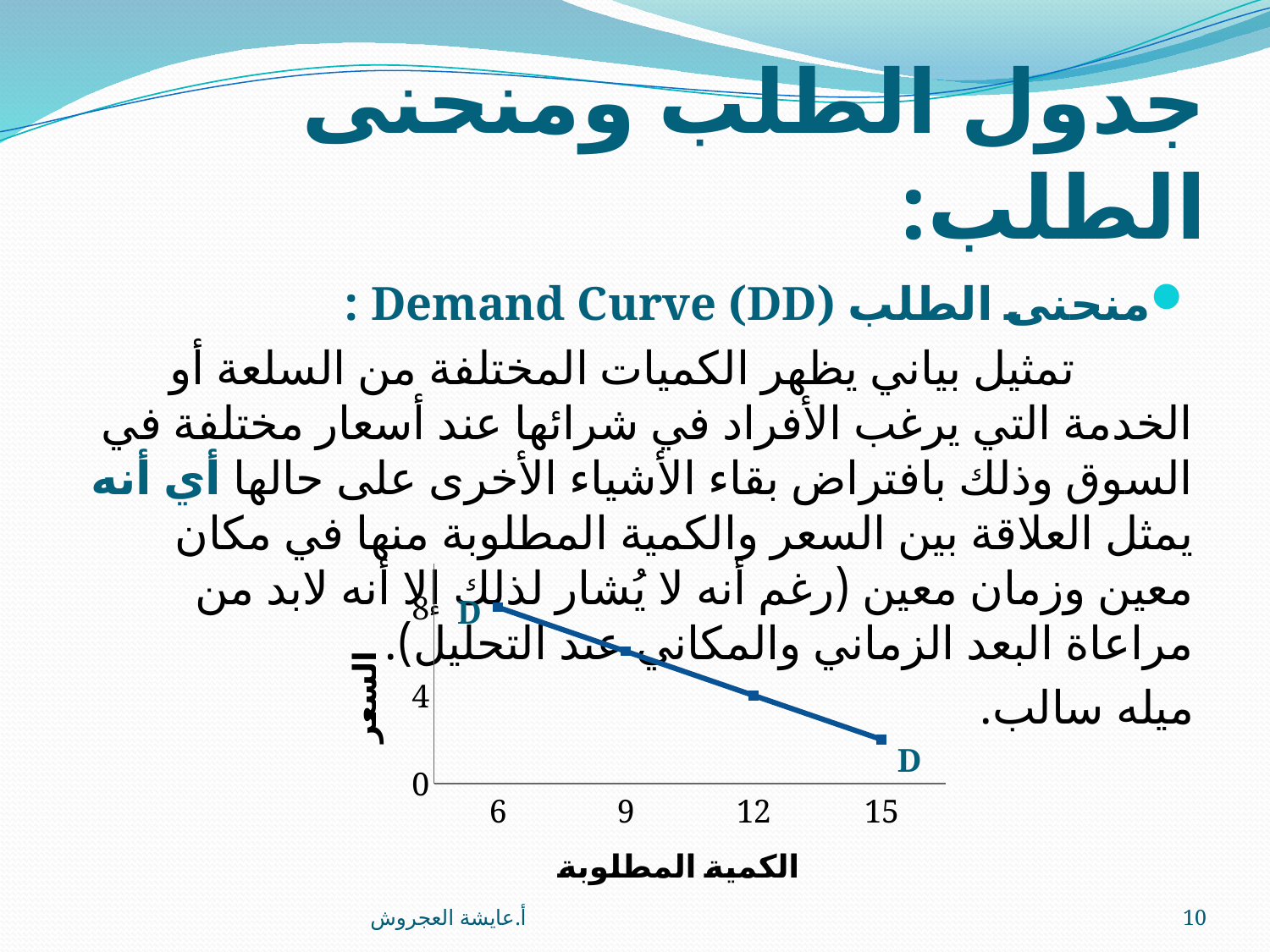
Is the price for a quantity demanded of 15 greater or less than 4? less Which has the higher price: a quantity demanded of 6 or a quantity demanded of 15? 6 What kind of chart is shown on the slide? line chart What letter labels the two ends of the demand curve? D How many data points are plotted on the demand curve? 4 What is the title of the x axis of the chart? الكمية المطلوبة Do the values rise or fall as the quantity demanded increases along the x axis? fall What is the price (السعر) when the quantity demanded is 6? 8 At which quantity demanded is the price lowest? 15 What is the price (السعر) when the quantity demanded is 12? 4 At which quantity demanded is the price highest? 6 Is the price for a quantity demanded of 9 greater or less than 4? greater